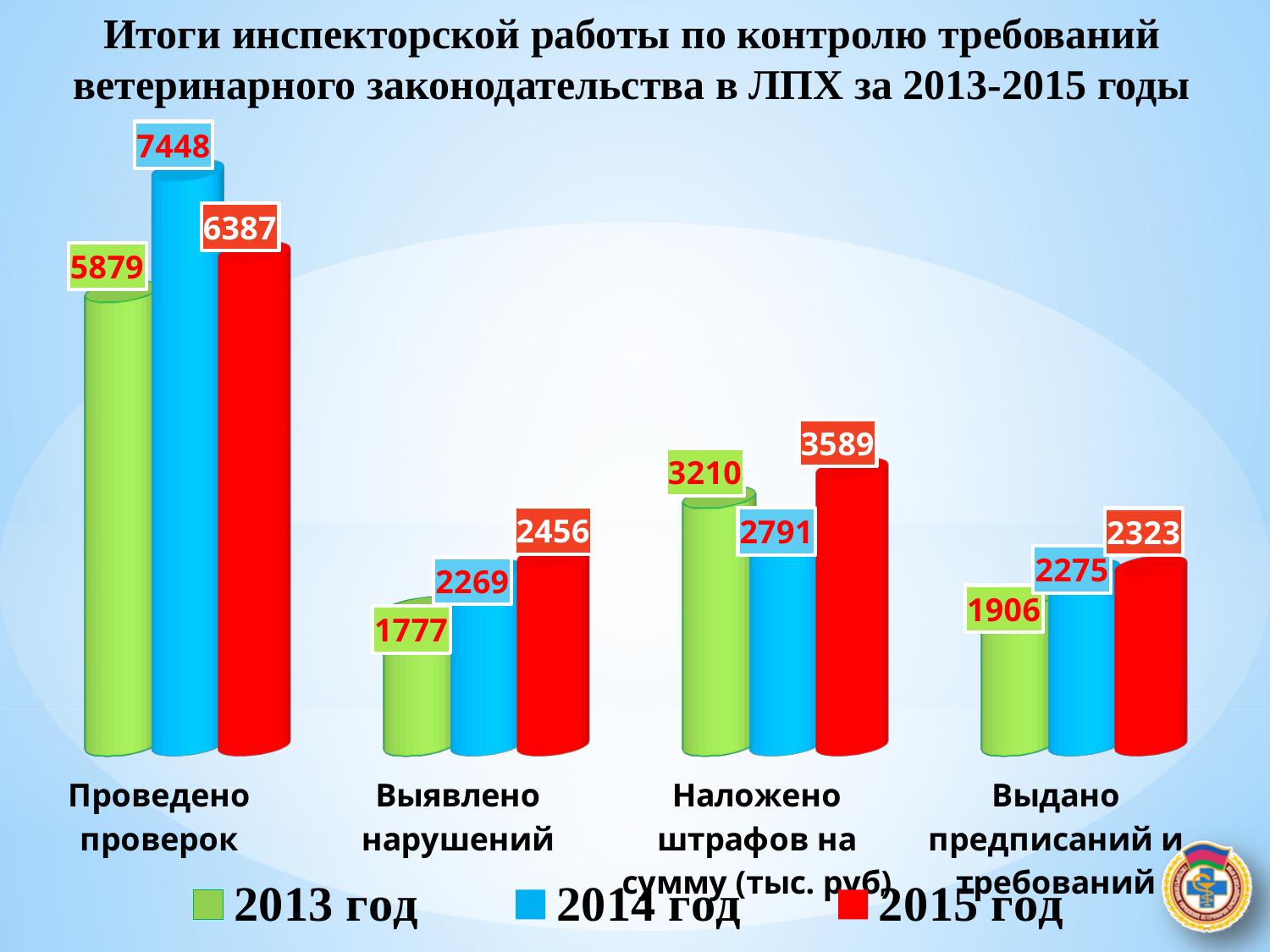
What is the difference between the 2014 год and 2013 год values in the category Проведено проверок? 1569 What is the difference between the 2015 год and 2014 год values in the category Выявлено нарушений? 187 What value is shown for 2015 год in the category Наложено штрафов на сумму (тыс. руб.)? 3589 Which year has the lowest value in the category Наложено штрафов на сумму (тыс. руб.)? 2014 год What value is shown for 2013 год in the category Выявлено нарушений? 1777 What kind of chart is shown on the slide? Bar chart How many series does the legend list? 3 Which year has the highest value in the category Проведено проверок? 2014 год What value is shown for 2014 год in the category Выдано предписаний и требований? 2275 Which is larger in the category Наложено штрафов на сумму (тыс. руб.): the value for 2013 год or for 2014 год? 2013 год What value is shown for 2014 год in the category Проведено проверок? 7448 How many categories are shown on the x axis of the chart? 4